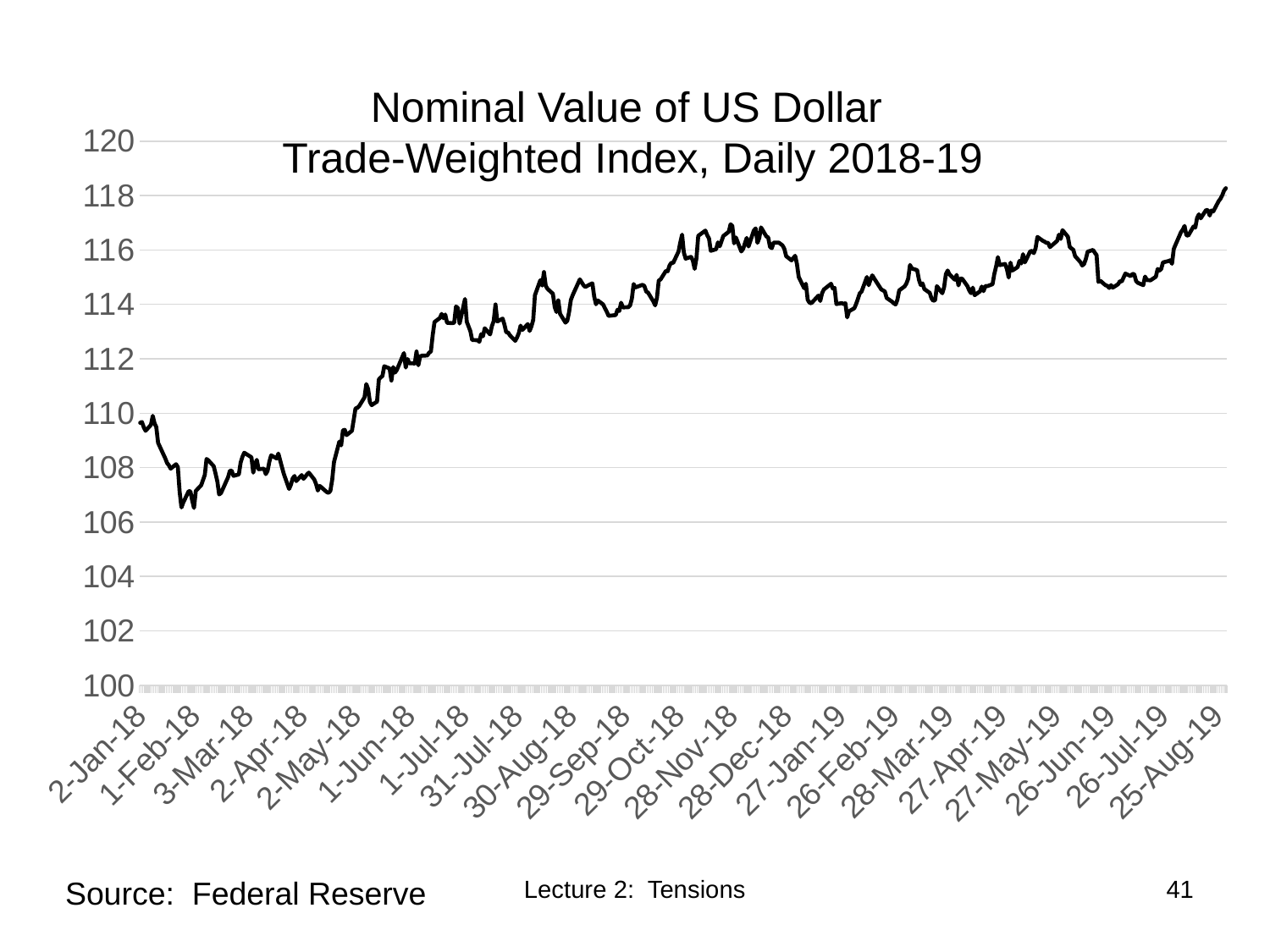
Around which x-axis date does the index reach its lowest point? 1-Feb-18 Is the value of the index on 2-Apr-18 greater or less than 110? less Is the value of the index on 28-Nov-18 greater or less than 114? greater Around which x-axis date does the index reach its highest point? 25-Aug-19 What is the title of the chart? Nominal Value of US Dollar Trade-Weighted Index, Daily 2018-19 Is the value of the index on 1-Jun-18 greater or less than 110? greater Overall, does the trade-weighted index rise or fall from 2-Jan-18 to 25-Aug-19? Rise What kind of chart is shown on the slide? Line chart Is the index value on 25-Aug-19 higher or lower than on 2-Jan-18? Higher